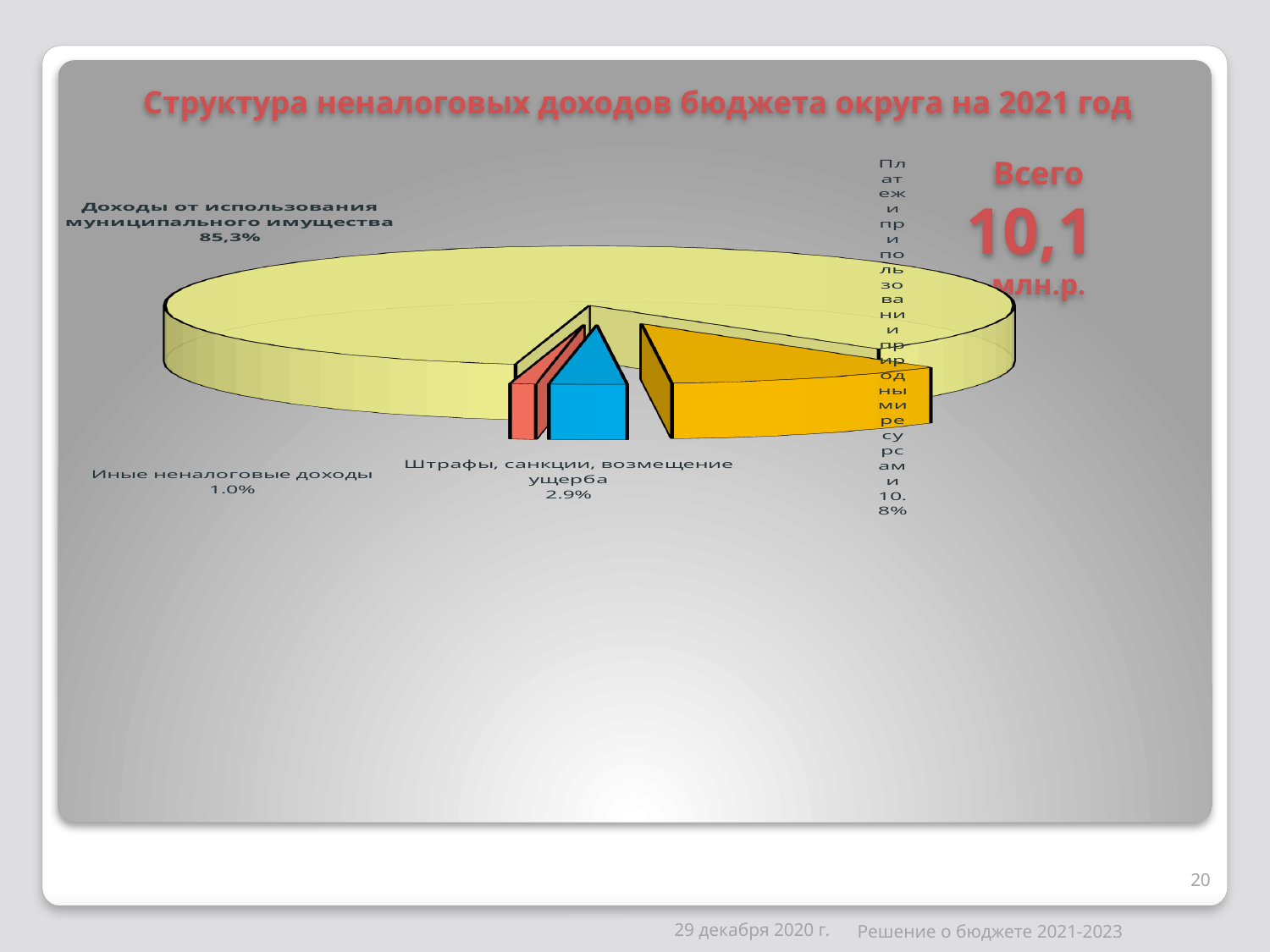
What total amount ("Всего") is stated next to the chart? 10,1 млн.р. Which category has the smallest slice of the pie? Иные неналоговые доходы Which category has the largest slice of the pie? Доходы от использования муниципального имущества What share is shown for "Иные неналоговые доходы"? 1.0% What is the title of the chart? Структура неналоговых доходов бюджета округа на 2021 год What kind of chart is shown on the slide? pie chart What share is shown for "Штрафы, санкции, возмещение ущерба"? 2.9% How many slices does the pie chart have? 4 What share of the pie is labelled for "Доходы от использования муниципального имущества"? 85,3% What share is shown for "Платежи при пользовании природными ресурсами"? 10.8% Which is larger: the share for "Штрафы, санкции, возмещение ущерба" or the share for "Иные неналоговые доходы"? Штрафы, санкции, возмещение ущерба What is the difference between the share for "Платежи при пользовании природными ресурсами" and the share for "Штрафы, санкции, возмещение ущерба"? 7.9%